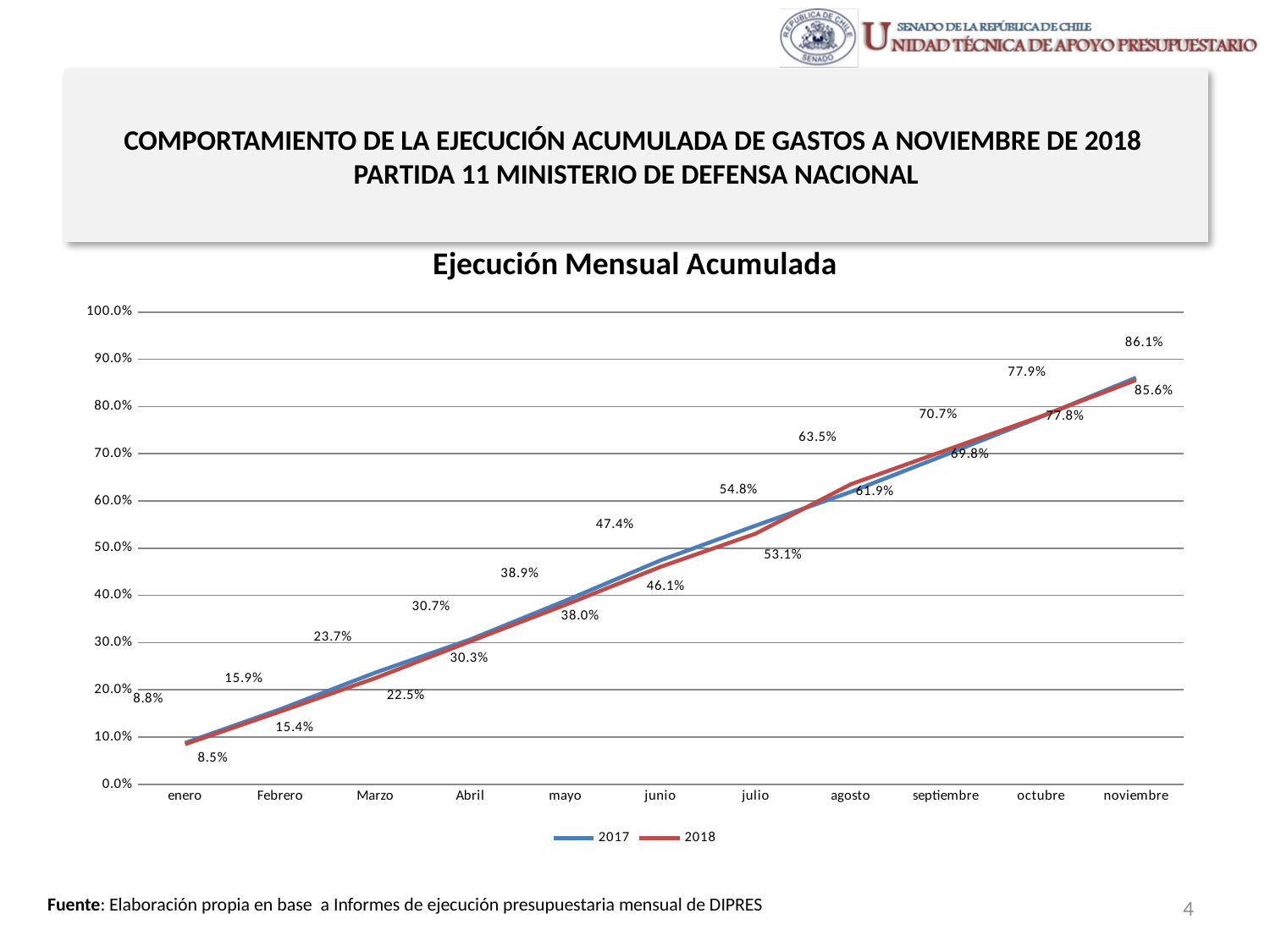
In which month is the 2018 value lowest? enero What is the value for 2018 in noviembre? 85.6% Do the values rise or fall from enero to noviembre? rise Which series has the higher value in agosto, 2017 or 2018? 2018 What is the value for 2017 in julio? 54.8% What is the value for 2018 in enero? 8.5% What is the title of the chart? Ejecución Mensual Acumulada What type of chart is shown on the slide? line chart How many series does the legend list? 2 How many months are shown on the x axis? 11 What is the value for 2017 in noviembre? 86.1% What is the difference between the 2017 and 2018 values in julio? 1.7%